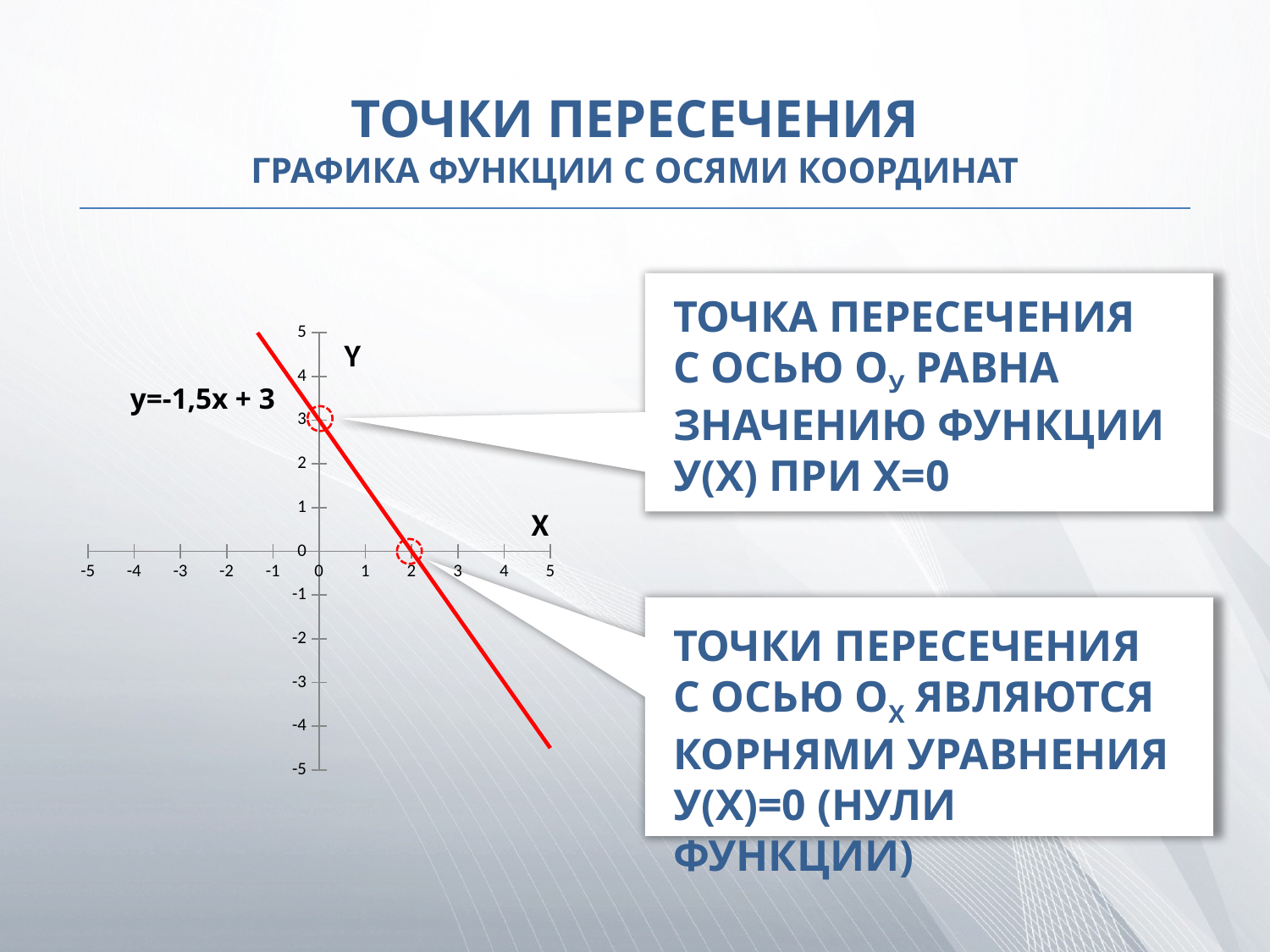
What is the equation of the function plotted on the chart? y=-1,5x + 3 What kind of chart is shown on the slide? line chart What is the highest value labelled on the X axis? 5 Is the value of y at x=4 on the plotted line greater or less than 0? less At what value of x does the plotted line cross the X axis? 2 What is the lowest value labelled on the Y axis? -5 Is the value of y at x=-1 on the plotted line greater or less than 4? greater Is the value of y where the line crosses the Y axis greater or less than 2? greater At what value of y does the plotted line cross the Y axis? 3 Does the plotted line rise or fall as x increases? fall How many intersection points with the axes are circled on the chart? 2